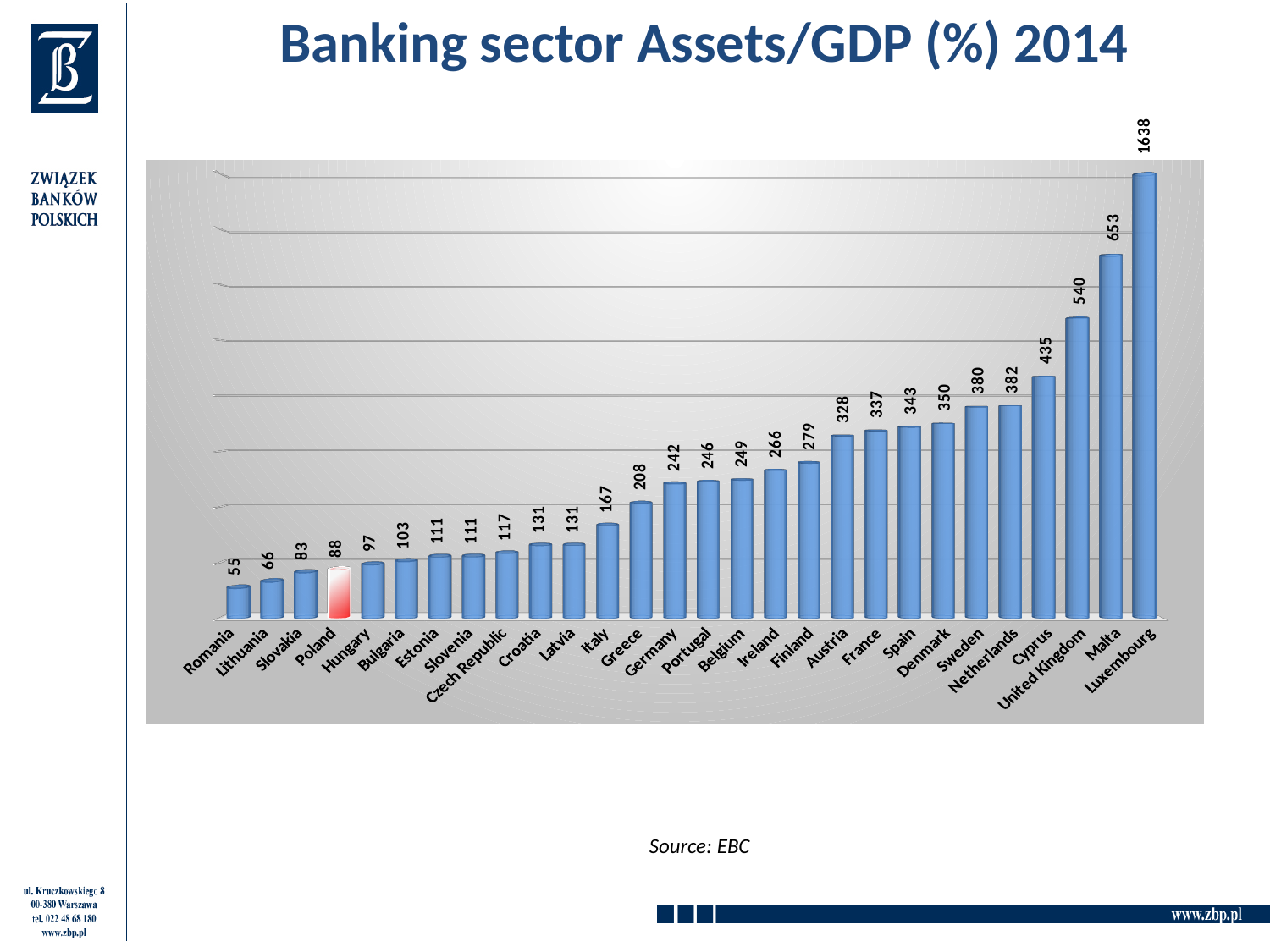
Which has a higher value, Sweden or Denmark? Sweden What is the value shown for Germany? 242 What is the difference between the values for Malta and the United Kingdom? 113 What is the banking sector assets/GDP value for Poland? 88 What is the value shown for Cyprus? 435 Which country has the lowest banking sector assets/GDP ratio? Romania What is the difference between the values for Poland and Romania? 33 What type of chart is shown on the slide? Bar chart Which country's bar is highlighted in red instead of blue? Poland How many countries are shown in the chart? 28 Which country has the highest banking sector assets/GDP ratio? Luxembourg Which has a higher value, Italy or Greece? Greece